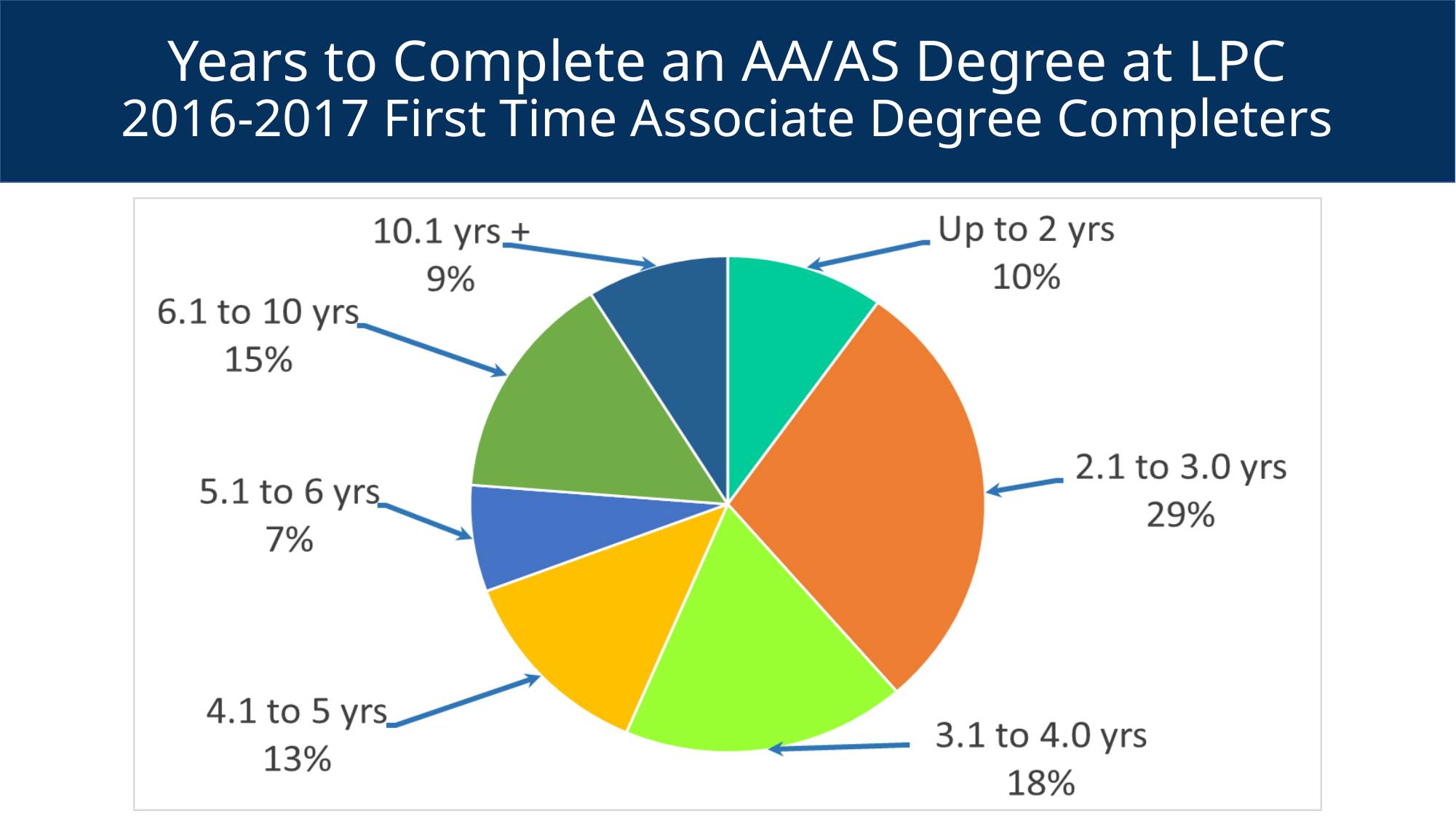
What is the difference in percentage points between the 3.1 to 4.0 yrs slice and the 4.1 to 5 yrs slice? 5 Which category has the largest share of the pie? 2.1 to 3.0 yrs What share of completers took 2.1 to 3.0 yrs to complete their degree? 29% Which is larger, the share for 4.1 to 5 yrs or the share for 6.1 to 10 yrs? 6.1 to 10 yrs What colour is the slice for 2.1 to 3.0 yrs? orange What percentage of completers finished in up to 2 yrs? 10% Which category has the smallest share of the pie? 5.1 to 6 yrs What is the combined share of completers who took 3.1 to 4.0 yrs and 4.1 to 5 yrs? 31% How many categories (slices) does the pie chart have? 7 What percentage of completers took 6.1 to 10 yrs? 15% What kind of chart is shown on the slide? pie chart What share of completers took 10.1 yrs +? 9%